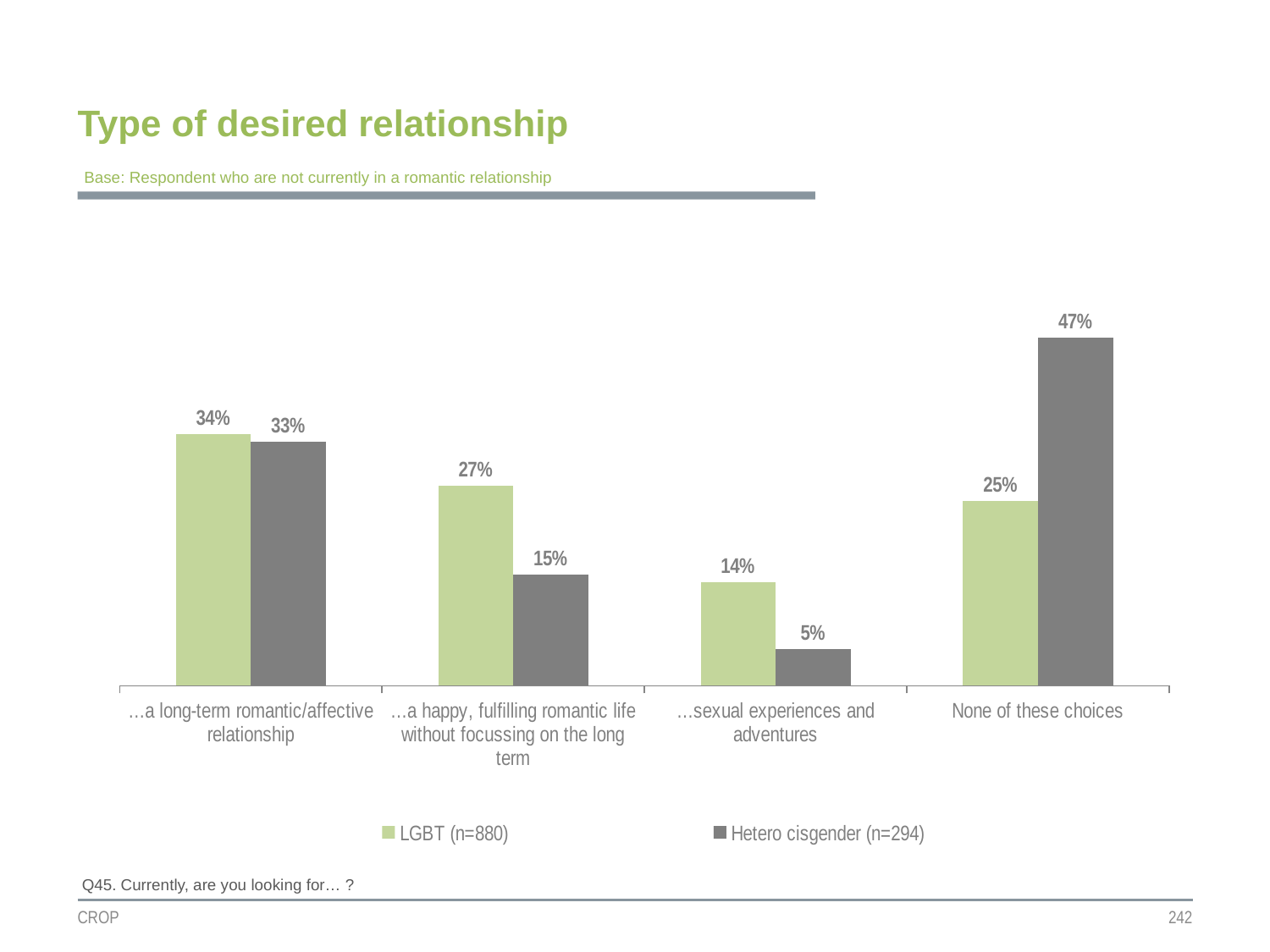
What is the title of the chart on the slide? Type of desired relationship What is the value for Hetero cisgender respondents for '…sexual experiences and adventures'? 5% What kind of chart is shown on the slide? Bar chart What is the difference between the LGBT and Hetero cisgender values for '…a happy, fulfilling romantic life without focussing on the long term'? 12 percentage points What is the sample size for the LGBT series shown in the legend? n=880 Which series has the larger value for 'None of these choices'? Hetero cisgender (n=294) Which category has the highest value for the LGBT series? …a long-term romantic/affective relationship How many categories are shown on the x axis? 4 How many series does the legend list? 2 What percentage of Hetero cisgender respondents chose 'None of these choices'? 47% Which category has the lowest value for the Hetero cisgender series? …sexual experiences and adventures What percentage of LGBT respondents are looking for a long-term romantic/affective relationship? 34%